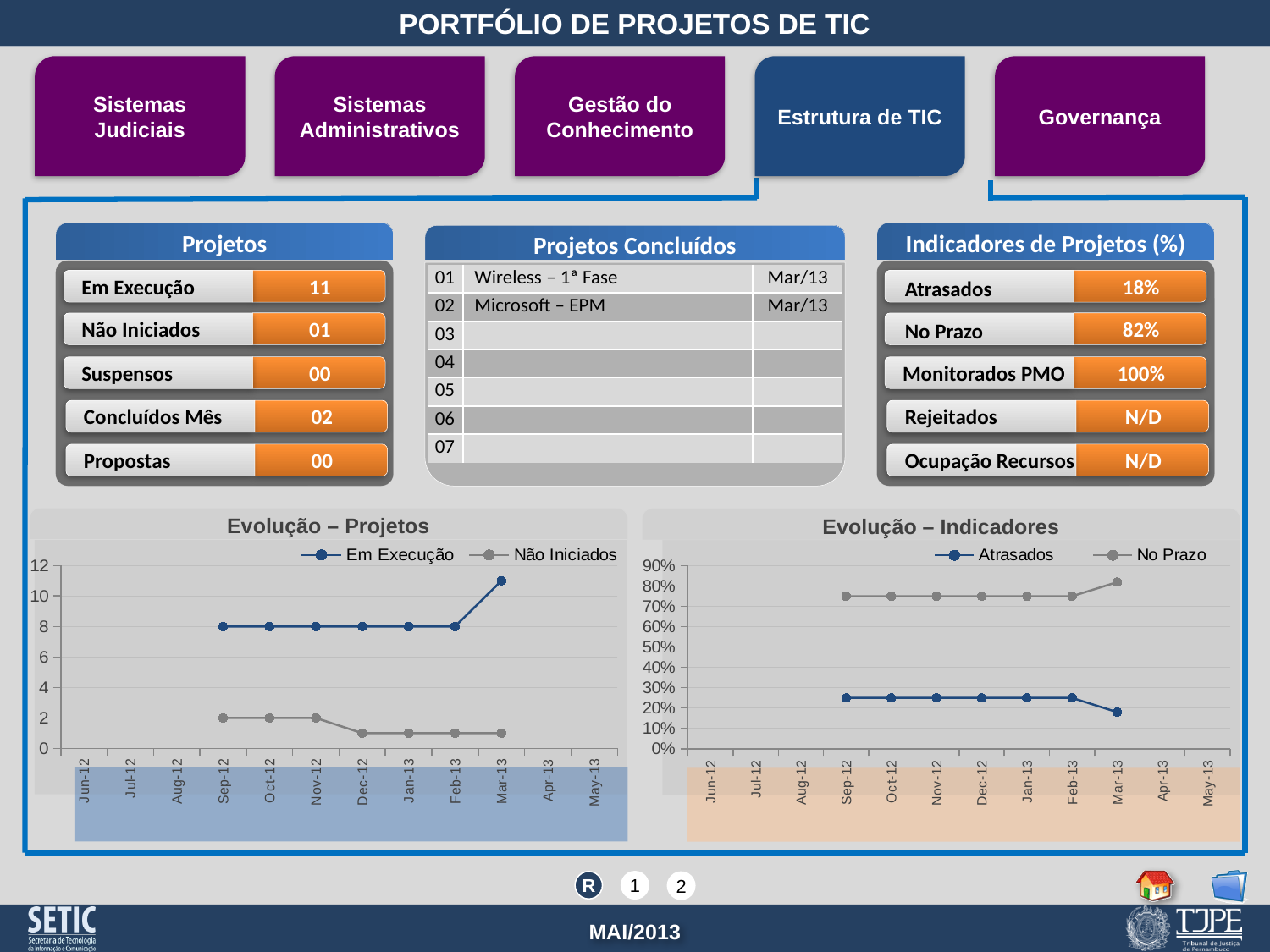
In the 'Evolução – Projetos' chart, is the value of Não Iniciados in Mar-13 greater or less than 2? less In the 'Evolução – Projetos' chart, what is the value of Não Iniciados in Sep-12? 2 In the 'Evolução – Projetos' chart, how many series does the legend list? 2 In the 'Evolução – Indicadores' chart, which series has the higher value in Sep-12, Atrasados or No Prazo? No Prazo What kind of chart is 'Evolução – Indicadores'? Line chart In the 'Evolução – Projetos' chart, which series has the higher value in Feb-13, Em Execução or Não Iniciados? Em Execução In the 'Evolução – Indicadores' chart, does the Atrasados series rise or fall from Feb-13 to Mar-13? Fall In the 'Evolução – Projetos' chart, what is the value of Em Execução in Sep-12? 8 In the 'Evolução – Projetos' chart, what is the difference between Em Execução and Não Iniciados in Sep-12? 6 In the 'Evolução – Projetos' chart, is the value of Em Execução in Mar-13 greater or less than 10? greater